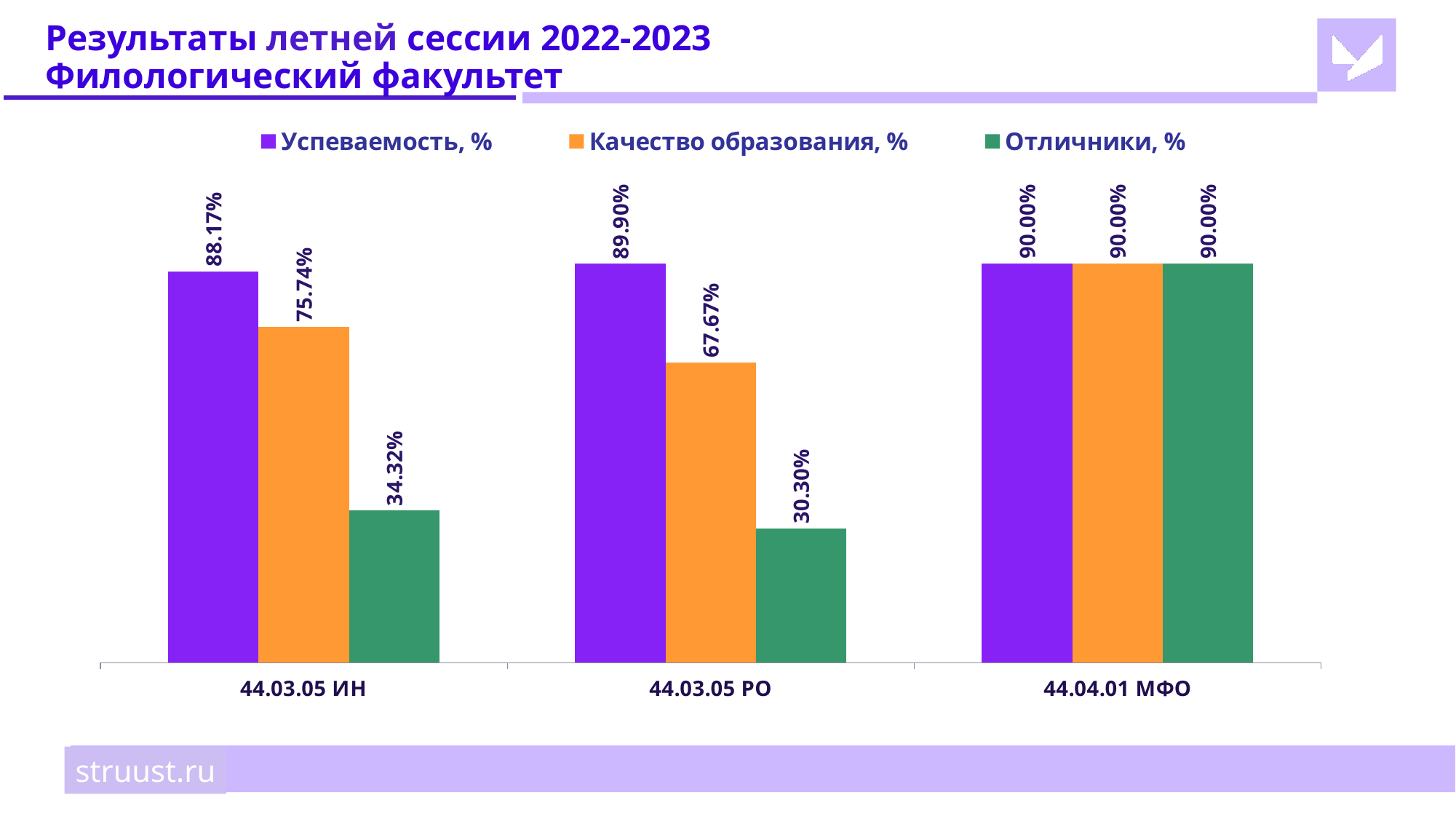
What is the value of Отличники, % for 44.04.01 МФО? 90.00% What is the value of Успеваемость, % for 44.03.05 ИН? 88.17% Which category has the highest value for Качество образования, %? 44.04.01 МФО How many series does the legend list? 3 What kind of chart is shown on the slide? Bar chart Which colour represents Качество образования, % in the legend? Orange How many categories are shown on the x axis? 3 What is the value of Отличники, % for 44.03.05 ИН? 34.32% Which is larger: Отличники, % for 44.03.05 ИН or for 44.03.05 РО? 44.03.05 ИН What is the value of Качество образования, % for 44.03.05 РО? 67.67% Which category has the lowest value for Отличники, %? 44.03.05 РО What is the difference between Успеваемость, % and Качество образования, % for 44.03.05 ИН? 12.43%